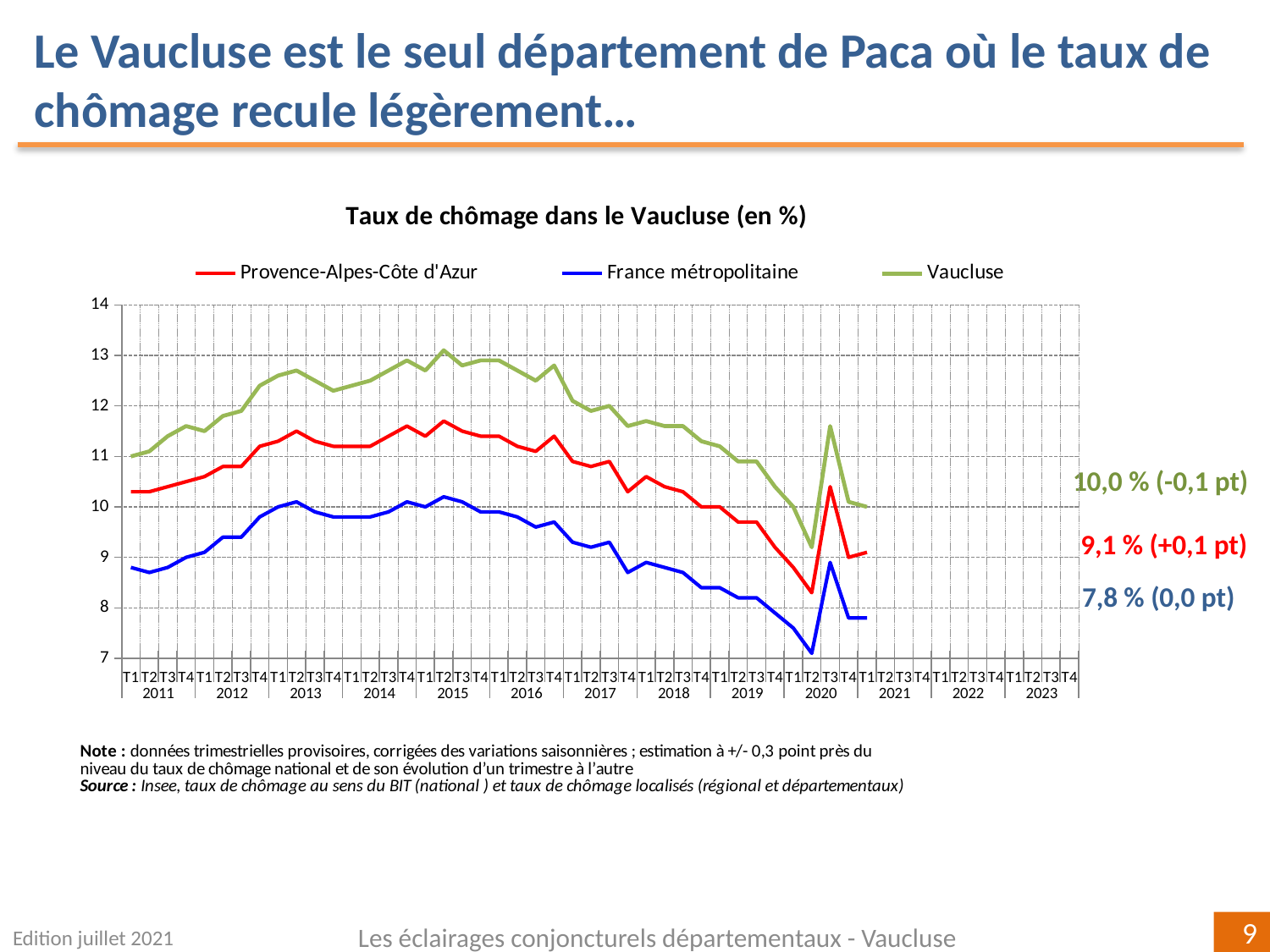
What quarterly change is indicated for the Vaucluse rate at the end of the series? -0,1 pt Is the value for France métropolitaine in T2 2020 greater or less than 8? less Which series has the highest values throughout the chart? Vaucluse What is the latest unemployment rate shown for Vaucluse? 10,0 % Does the Vaucluse rate rise or fall between 2016 and 2019? fall How many series does the legend list? 3 What kind of chart is shown on the slide? line chart What is the latest unemployment rate shown for France métropolitaine? 7,8 % Which series has the lowest values throughout the chart? France métropolitaine What is the latest unemployment rate shown for Provence-Alpes-Côte d'Azur? 9,1 % What is the difference between the latest Vaucluse rate and the latest France métropolitaine rate? 2,2 points What is the title of the chart? Taux de chômage dans le Vaucluse (en %)